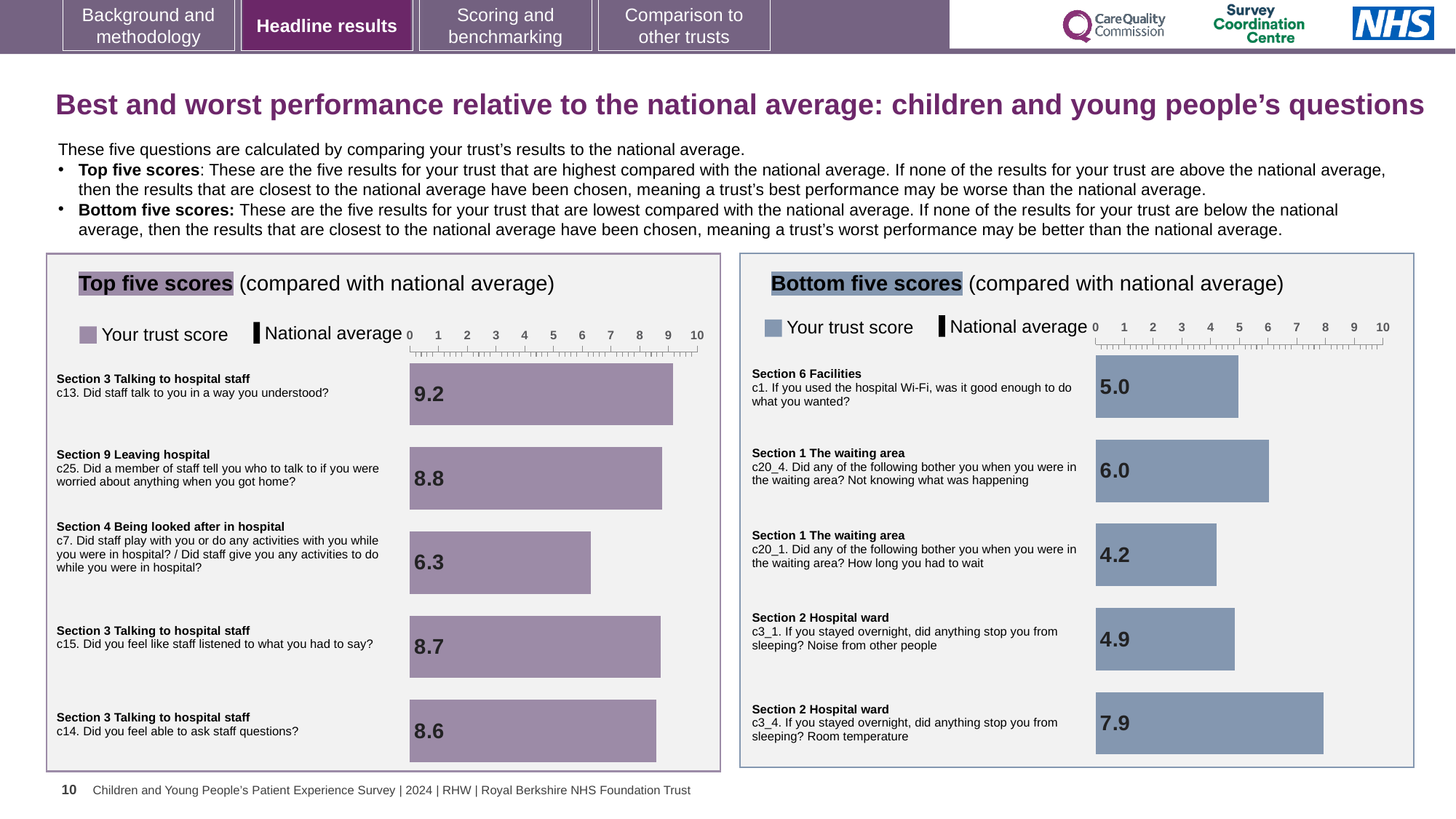
In the Top five scores chart, which question has the highest trust score? c13. Did staff talk to you in a way you understood? In the Top five scores chart, what is the difference between the trust scores for c13 and c14? 0.6 In the Bottom five scores chart, what is the trust score for c1 about the hospital Wi-Fi? 5.0 How many questions are shown in the Bottom five scores chart? 5 In the Bottom five scores chart, what is the trust score for c3_4 about room temperature stopping you from sleeping? 7.9 In the Top five scores chart, which has the larger trust score: c25 or c15? c25 In the Bottom five scores chart, what is the difference between the trust scores for c20_4 and c3_1? 1.1 In the Top five scores chart, what is the trust score for c13 'Did staff talk to you in a way you understood?' 9.2 What type of chart is the Top five scores chart? Bar chart In the Top five scores chart, what is the trust score for c7 about staff playing with you or giving you activities while in hospital? 6.3 In the Bottom five scores chart, which question has the lowest trust score? c20_1. Did any of the following bother you when you were in the waiting area? How long you had to wait How many series does the legend of the Bottom five scores chart list? 2